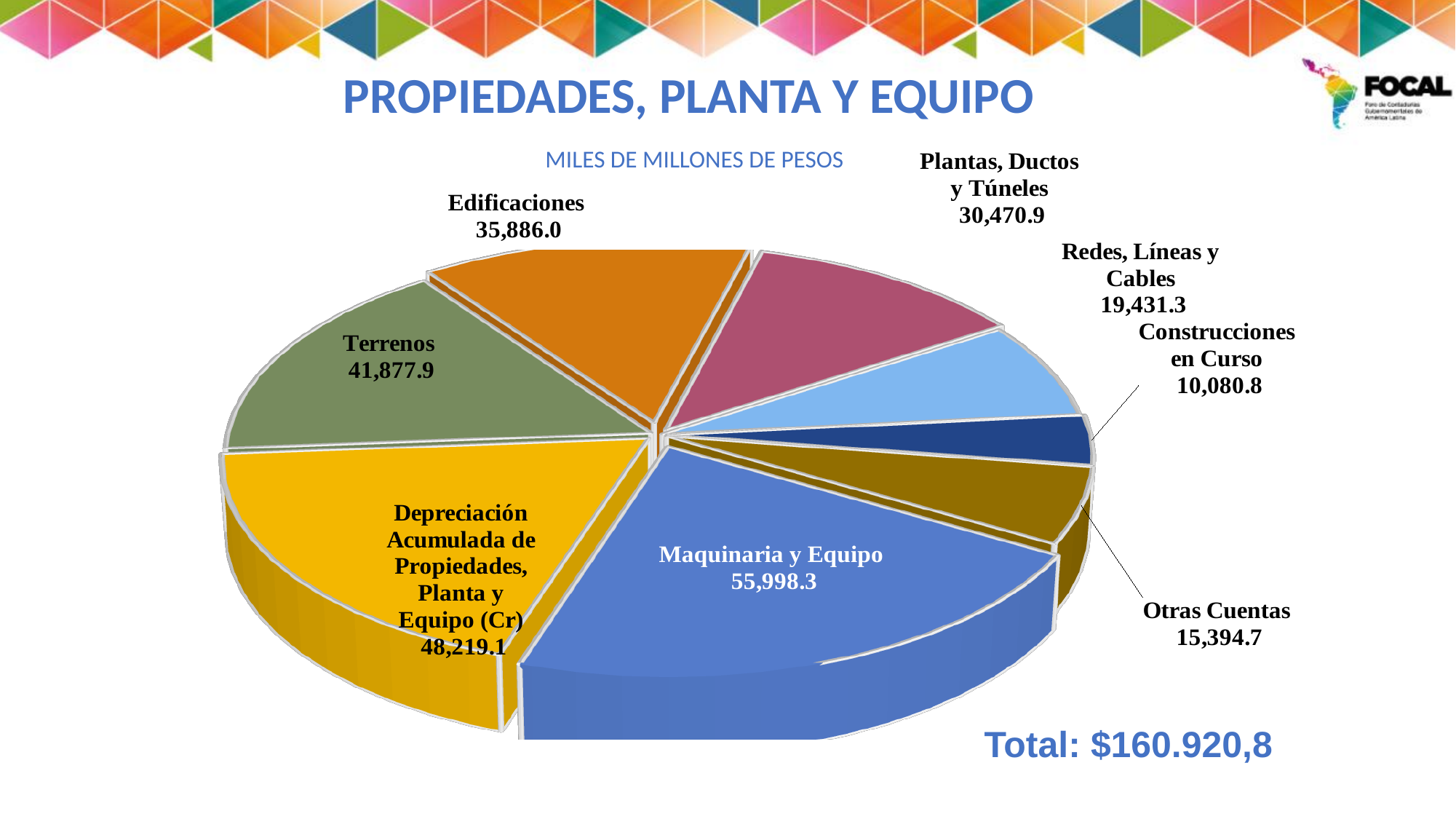
What is the value for Construcciones en Curso? 10,080.8 Which category has the largest value? Maquinaria y Equipo How many slices does the pie chart have? 8 What is the value for Maquinaria y Equipo? 55,998.3 What is the value for Terrenos? 41,877.9 What is the value for Redes, Líneas y Cables? 19,431.3 Which is larger, Terrenos or Edificaciones? Terrenos What is the difference between the values for Plantas, Ductos y Túneles and Redes, Líneas y Cables? 11,039.6 Which category has the smallest value? Construcciones en Curso What type of chart is shown on the slide? Pie chart What unit is stated in the subtitle above the chart? MILES DE MILLONES DE PESOS What is the difference between the values for Maquinaria y Equipo and Depreciación Acumulada de Propiedades, Planta y Equipo (Cr)? 7,779.2